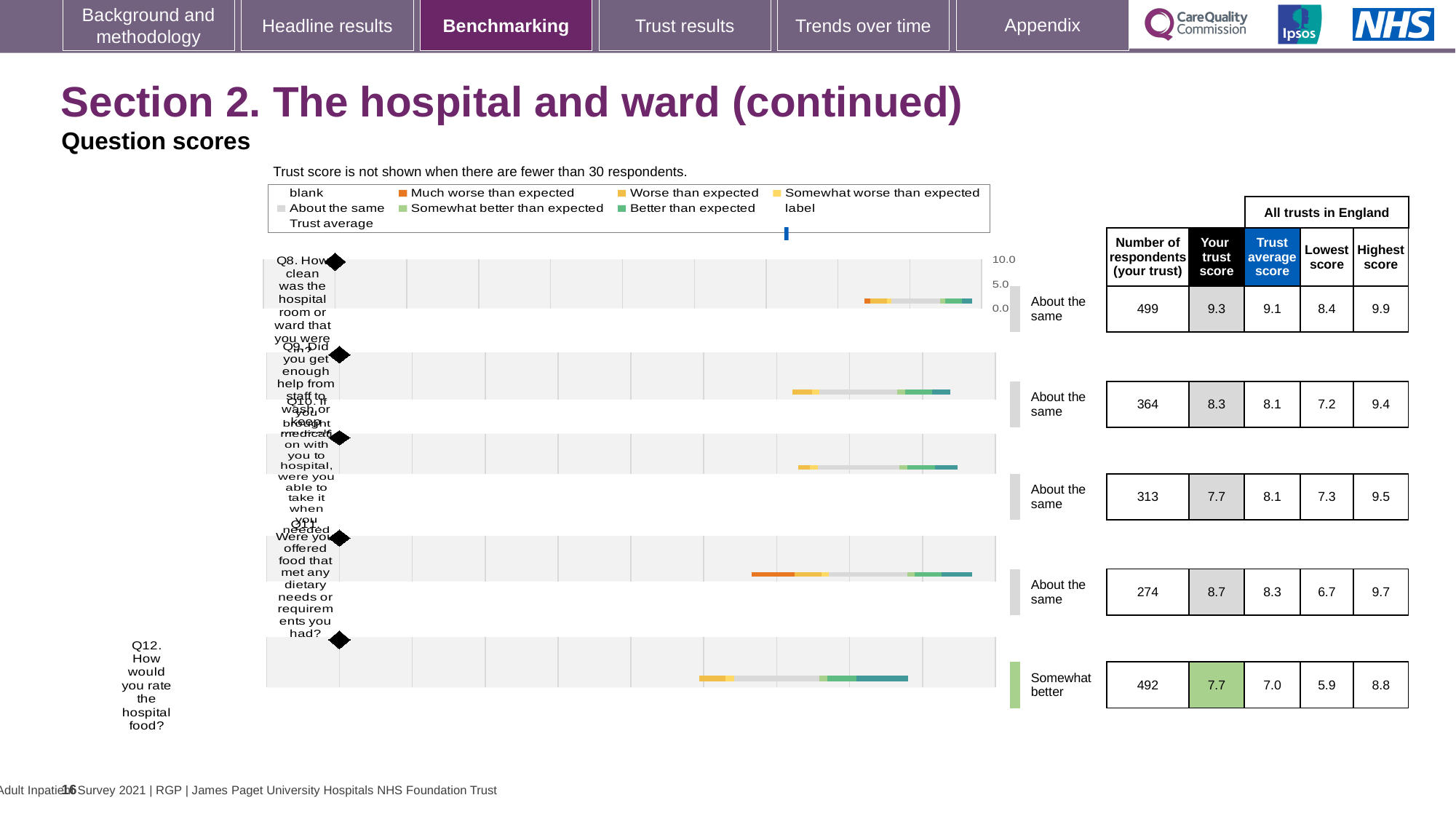
How many questions (Q8 to Q12) are plotted in the chart? 5 For Q8, what is the difference between the highest score and the lowest score across all trusts in England? 1.5 What kind of chart is used to show the question scores on this slide? bar chart What is the highest score across all trusts in England for Q10 (taking your own medication when needed)? 9.5 Which question is rated 'Somewhat better' rather than 'About the same'? Q12 How many respondents from your trust answered Q12 (how would you rate the hospital food)? 492 Which question has the highest 'Your trust score'? Q8 For Q12, how much higher is your trust score than the trust average score? 0.7 What is the lowest score across all trusts in England for Q11 (food that met dietary needs)? 6.7 Which question has the fewest respondents from your trust? Q11 For Q9, which is larger: your trust score or the trust average score? Your trust score What is the 'Your trust score' for Q8 (how clean was the hospital room or ward)? 9.3